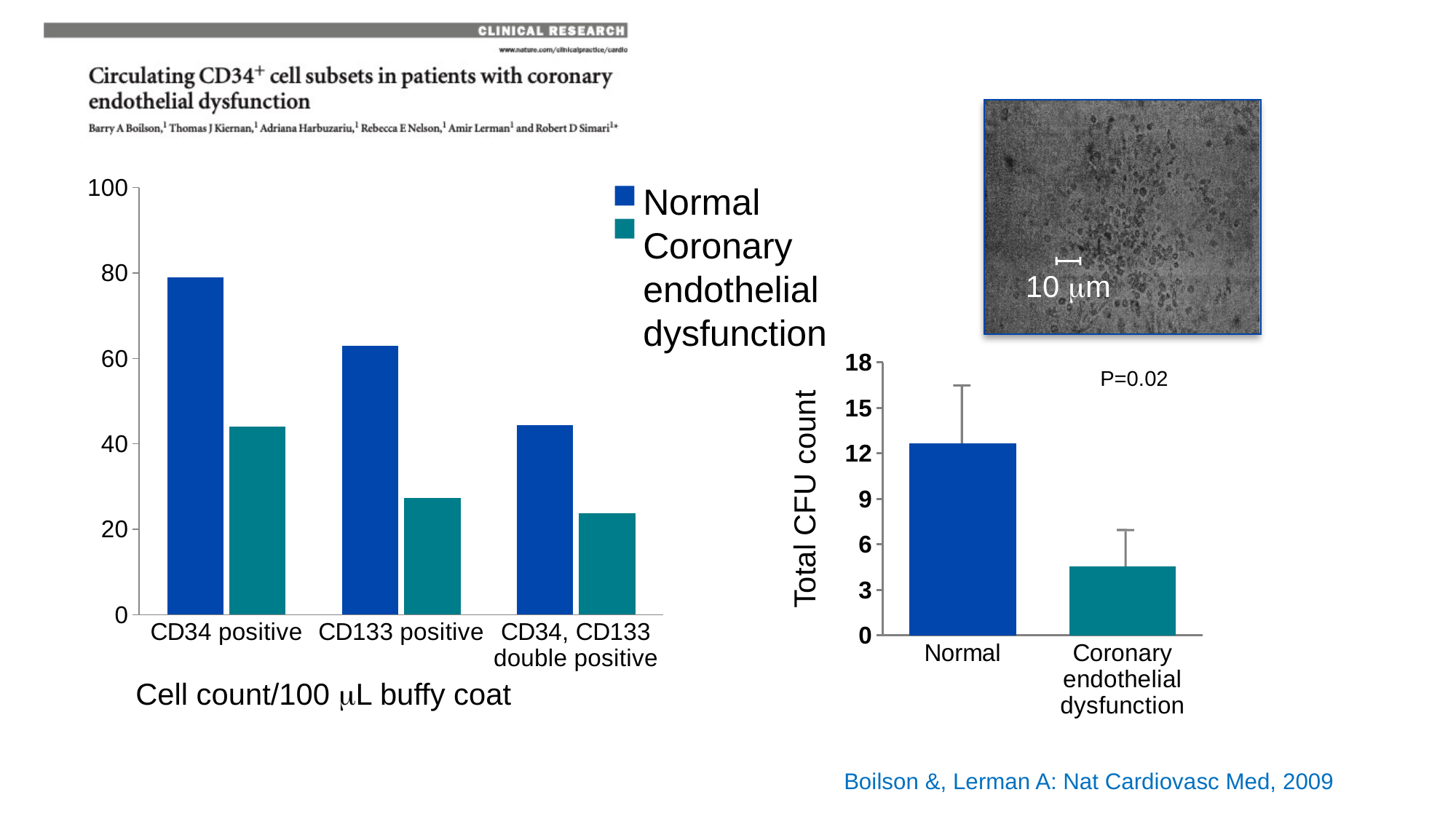
How many series does the legend of the left chart (Cell count/100 µL buffy coat) list? 2 In the right chart (Total CFU count), is the value for Normal greater or less than 9? greater How many categories are shown on the x axis of the left chart (Cell count/100 µL buffy coat)? 3 In the left chart (Cell count/100 µL buffy coat), which is larger for CD133 positive: the Normal value or the Coronary endothelial dysfunction value? Normal In the right chart (Total CFU count), is the value for Coronary endothelial dysfunction greater or less than 6? less In the left chart (Cell count/100 µL buffy coat), is the Coronary endothelial dysfunction value for CD133 positive greater or less than 40? less What kind of chart is the left chart (Cell count/100 µL buffy coat)? bar chart In the left chart (Cell count/100 µL buffy coat), which category has the highest Normal value? CD34 positive In the right chart (Total CFU count), which category has the higher bar? Normal In the left chart (Cell count/100 µL buffy coat), which category has the lowest Coronary endothelial dysfunction value? CD34, CD133 double positive What P value is printed on the right chart (Total CFU count)? P=0.02